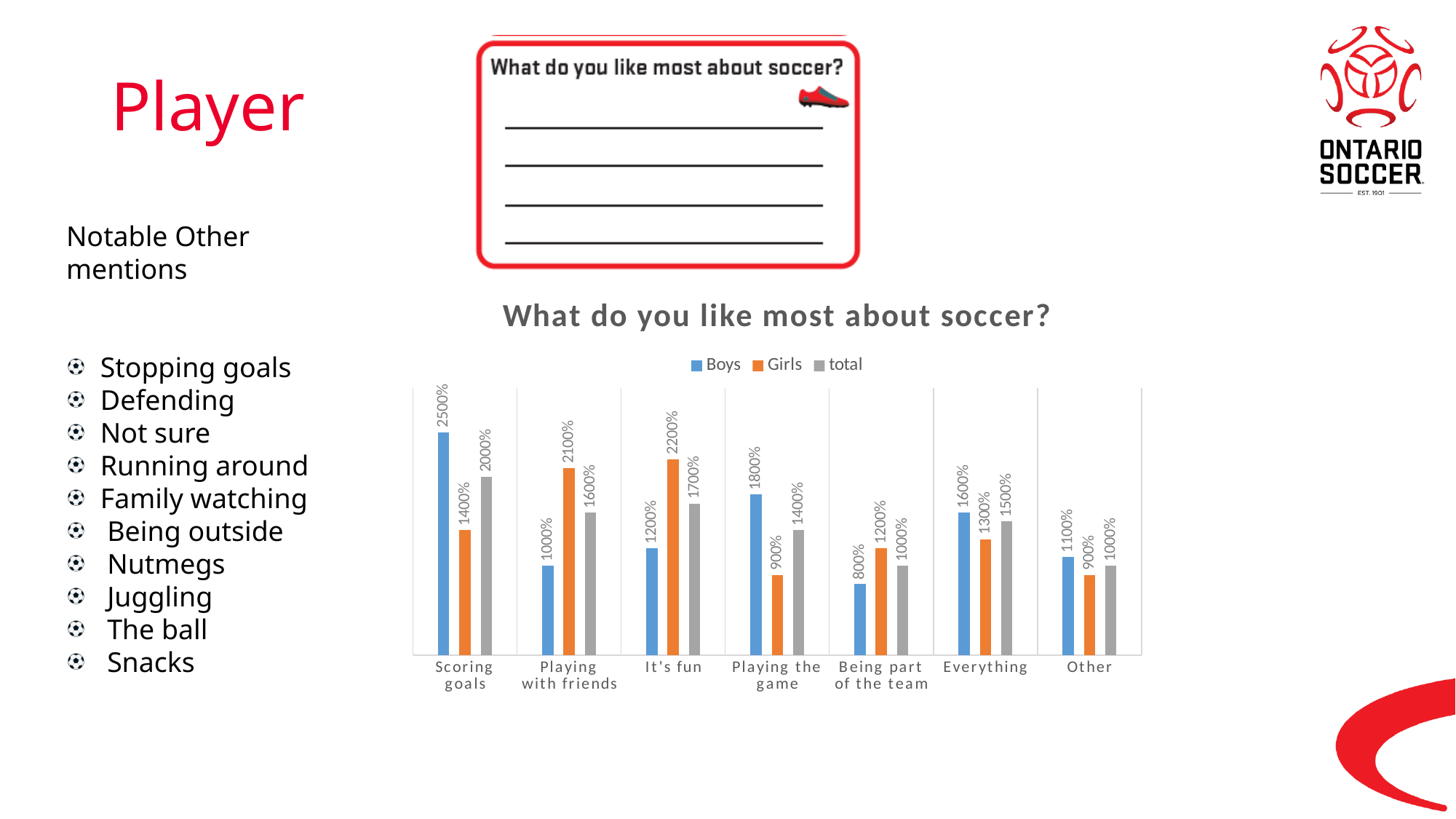
Which category has the lowest Boys value? Being part of the team What is the Boys value for Scoring goals? 2500% What kind of chart is shown? Bar chart What is the Girls value for Playing the game? 900% Which category has the highest Girls value? It's fun Which category has the highest Boys value? Scoring goals How many series does the legend list? 3 Which is larger for Being part of the team, the Boys value or the Girls value? Girls How many categories are shown on the x axis? 7 What is the Girls value for It's fun? 2200% What is the total value for Everything? 1500% What is the difference between the Boys and Girls values for Playing with friends? 1100%